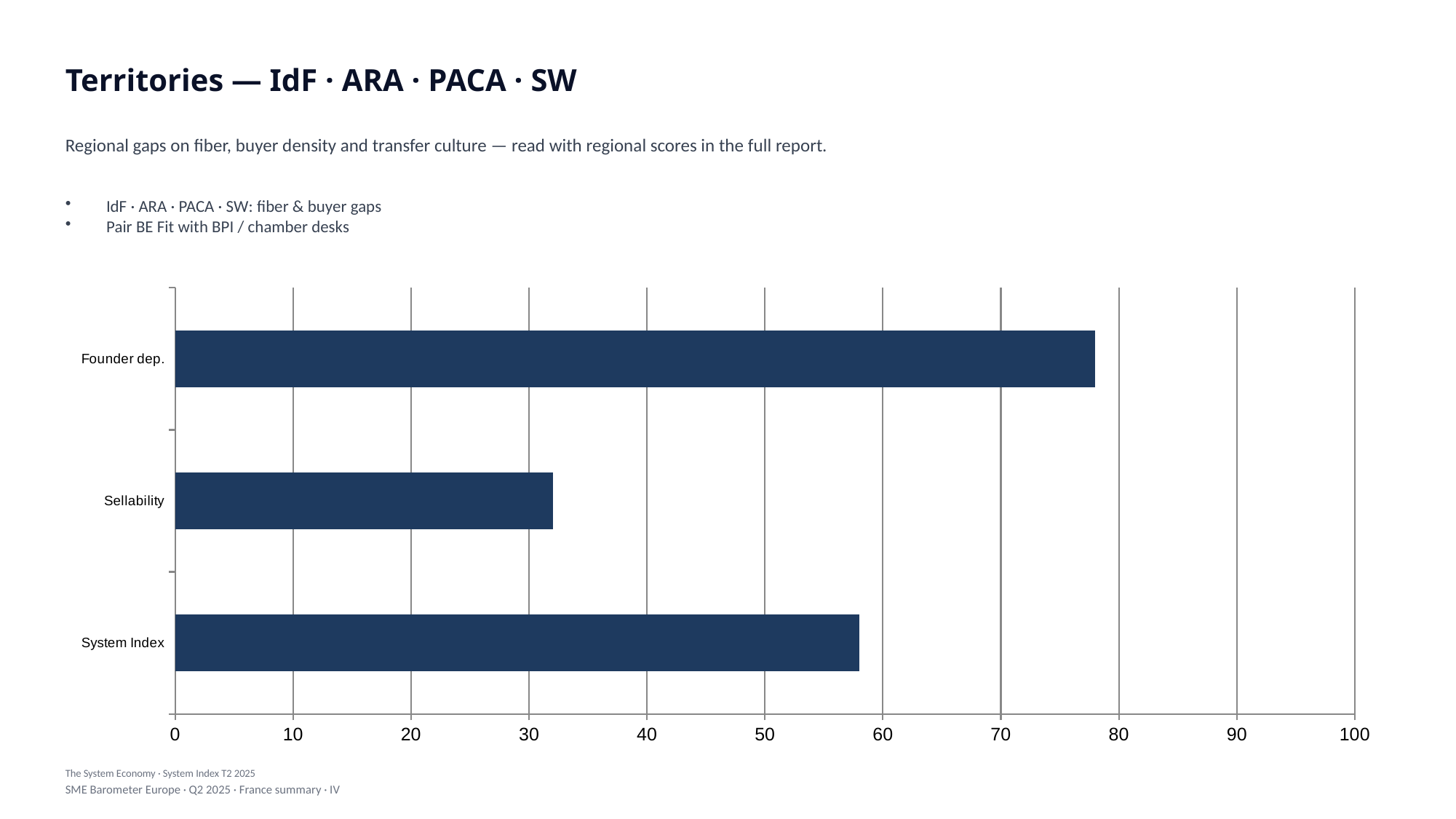
How many categories does the bar chart show? 3 Is the value for Founder dep. greater or less than 70? greater What is the maximum value shown on the horizontal axis of the chart? 100 Which category has the lowest value in the bar chart? Sellability What kind of chart is shown on the slide? bar chart Which is larger, the value for Founder dep. or the value for System Index? Founder dep. What is the title of the slide containing the bar chart? Territories — IdF · ARA · PACA · SW Is the value for System Index greater or less than 50? greater Is the value for Sellability greater or less than 40? less Which category has the highest value in the bar chart? Founder dep. Which is larger, the value for Sellability or the value for System Index? System Index